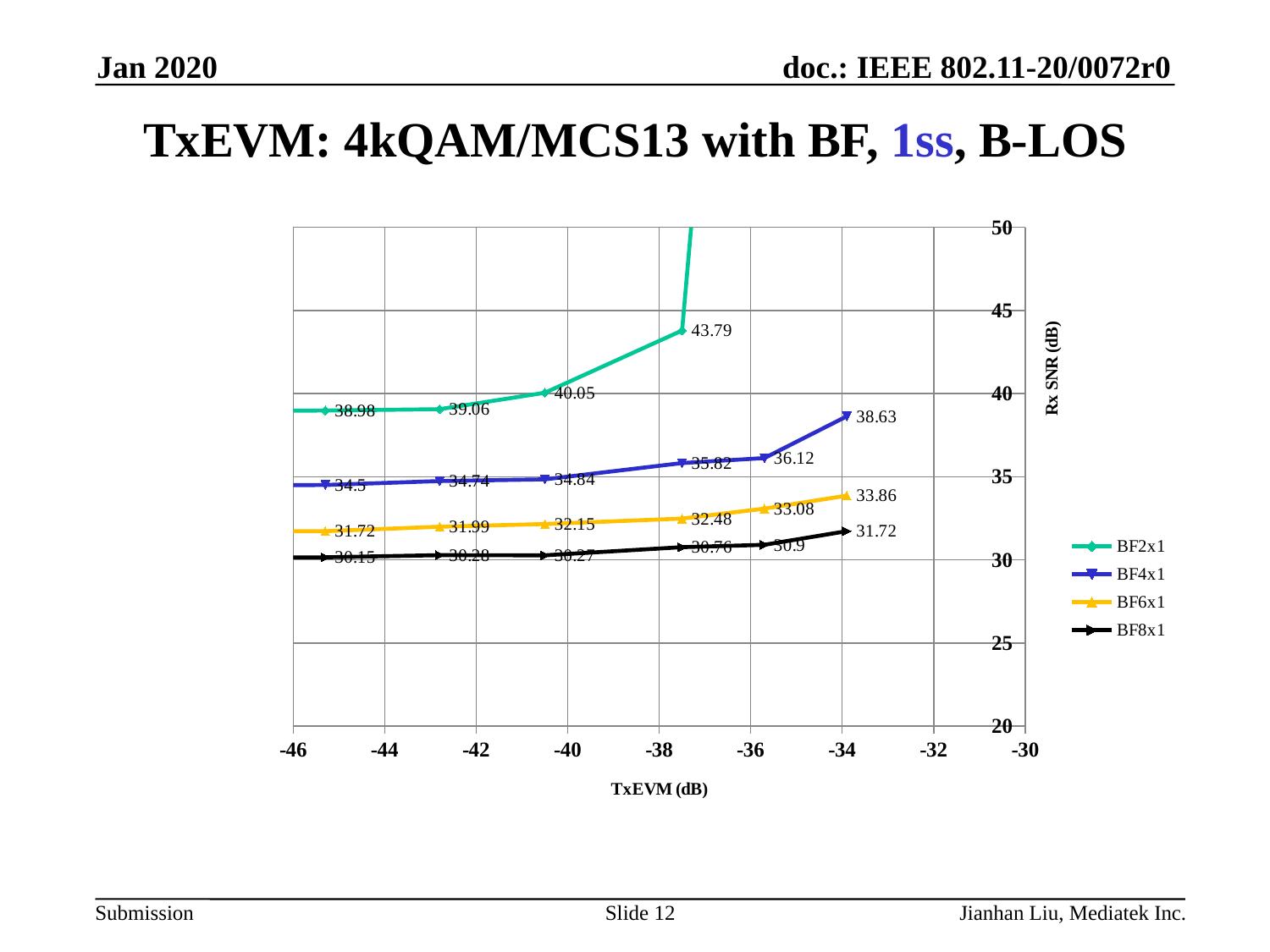
What is the highest labeled Rx SNR value on the BF2x1 line? 43.79 What is the rightmost labeled value on the BF6x1 line? 33.86 How many series does the legend list? 4 What is the leftmost labeled value on the BF8x1 line? 30.15 At the leftmost labeled point, which series has the larger Rx SNR, BF4x1 or BF6x1? BF4x1 What are the series names listed in the legend? BF2x1, BF4x1, BF6x1, BF8x1 Which series has the lowest Rx SNR values across the chart? BF8x1 Does the BF2x1 line rise or fall as TxEVM increases from -46 toward -30? rise What is the rightmost labeled value on the BF4x1 line? 38.63 What kind of chart is shown on the slide? line chart How many labeled data points are on the BF4x1 line? 6 What is the difference between the rightmost labeled values of BF4x1 (38.63) and BF6x1 (33.86)? 4.77